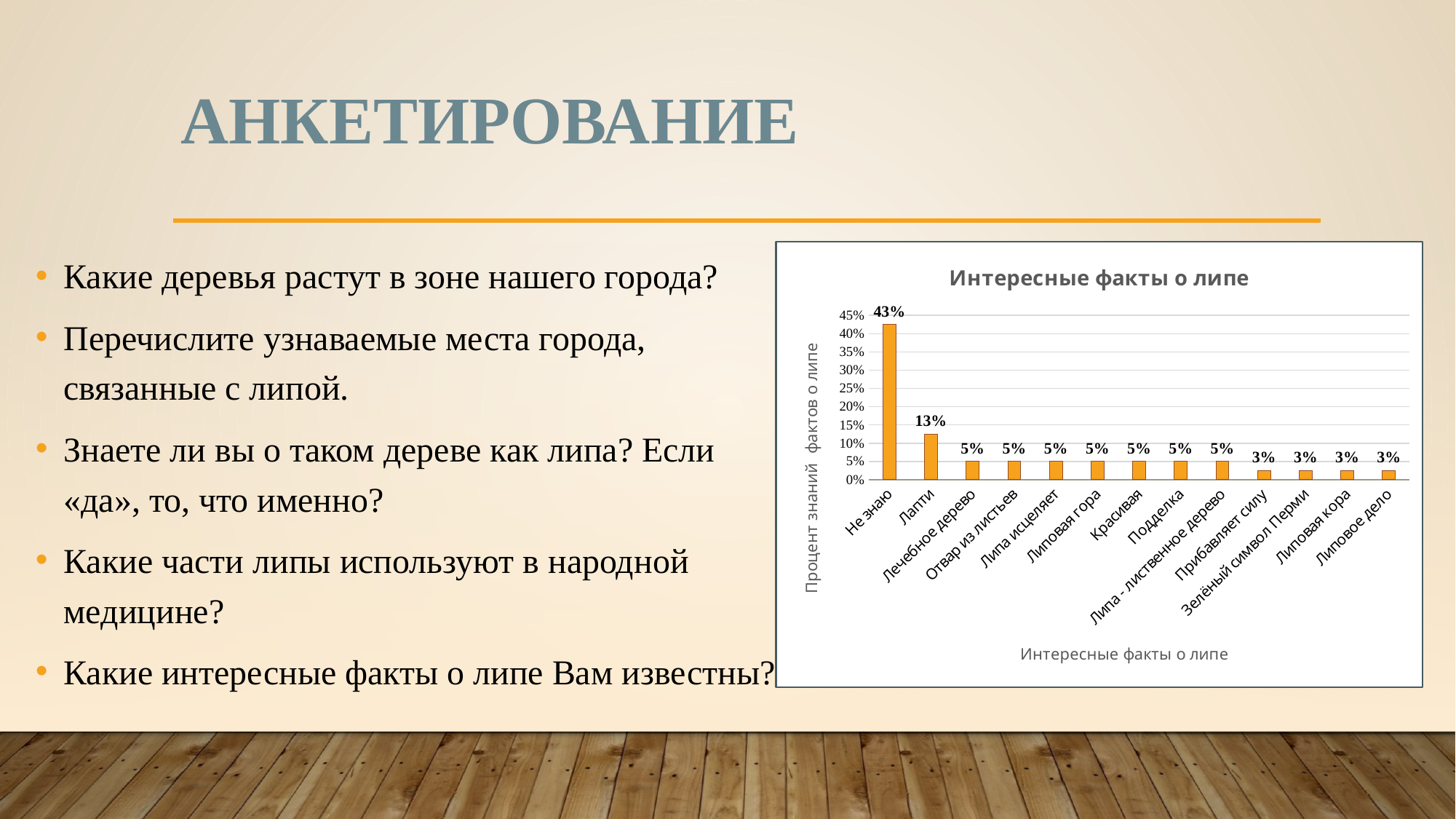
How many categories are shown on the x axis? 13 What is the value for "Не знаю"? 43% What is the title of the chart? Интересные факты о липе What is the value for "Лапти"? 13% What is the value for "Зелёный символ Перми"? 3% What type of chart is shown on the slide? bar chart Which category has the highest value? Не знаю Which is larger, the value for "Лапти" or the value for "Красивая"? Лапти What is the lowest value shown in the chart? 3% What is the value for "Липовая гора"? 5% What is the difference between the values for "Не знаю" and "Лапти"? 30% What is the label of the vertical axis? Процент знаний фактов о липе